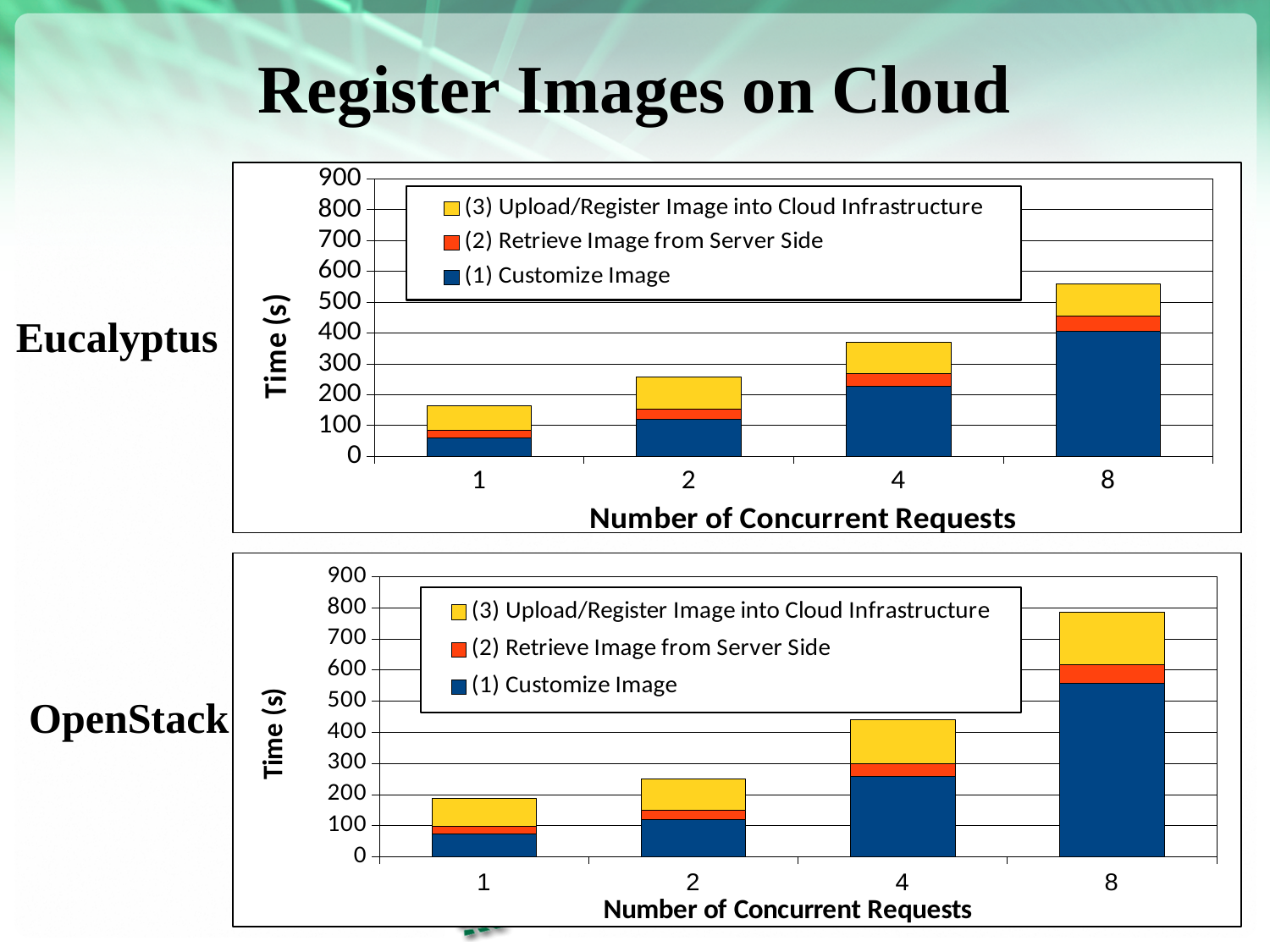
What type of chart is the Eucalyptus chart? stacked bar chart In the OpenStack chart, which number of concurrent requests has the lowest total time? 1 In the OpenStack chart, is the total time for 4 concurrent requests greater or less than 400? greater In the Eucalyptus chart, does the total time rise or fall as the number of concurrent requests increases? rise In the OpenStack chart, which has the larger total time: 4 concurrent requests or 8 concurrent requests? 8 concurrent requests What is the y-axis label of the OpenStack chart? Time (s) In the Eucalyptus chart, is the total time for 8 concurrent requests greater or less than 500? greater How many series does the legend of the OpenStack chart list? 3 In the Eucalyptus chart, which number of concurrent requests has the highest total time? 8 In the Eucalyptus chart, is the total time for 1 concurrent request greater or less than 200? less How many categories are shown on the x axis of the Eucalyptus chart? 4